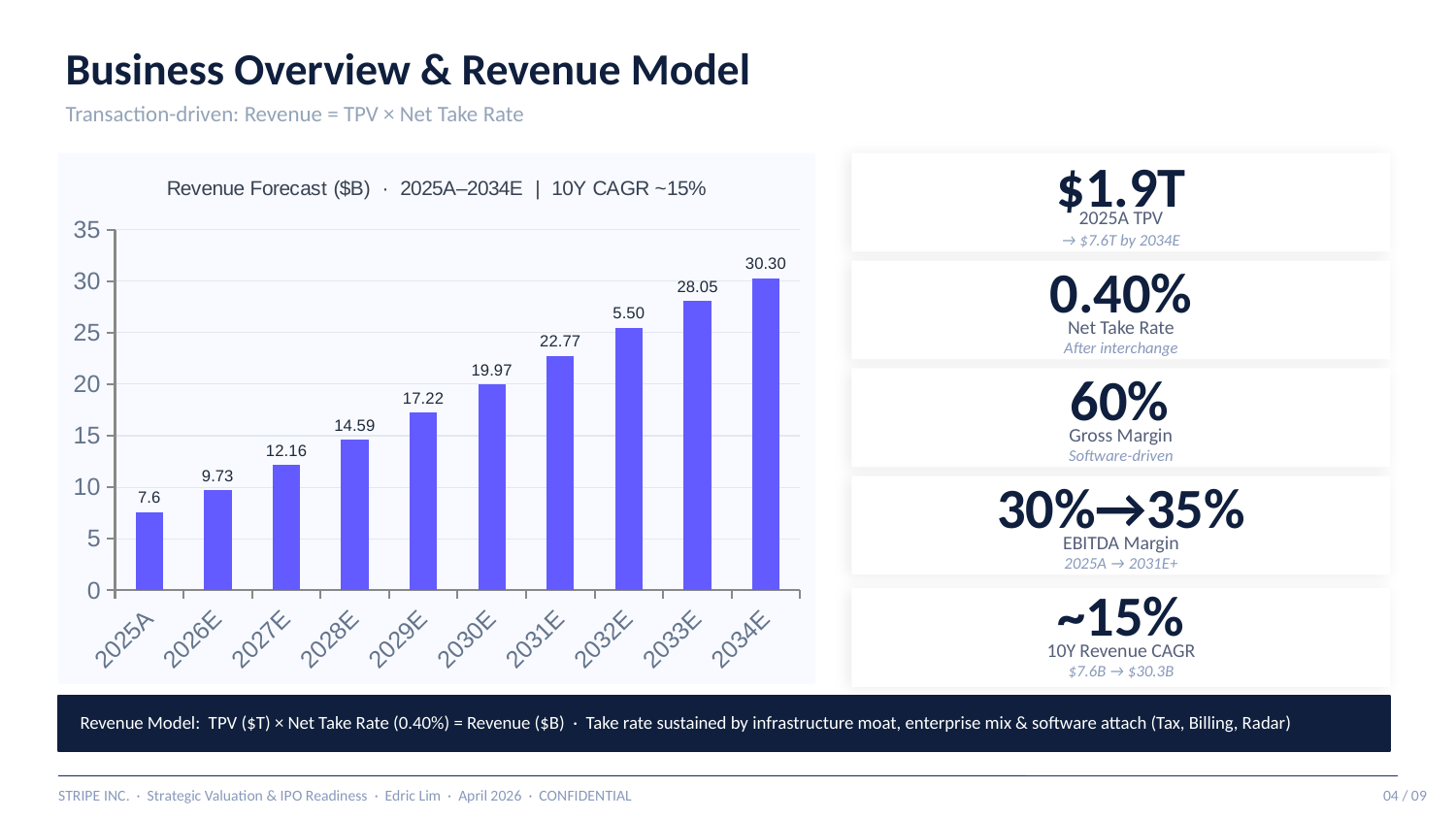
Do the revenue forecast values rise or fall from 2025A to 2034E? Rise Which year has the lowest revenue forecast? 2025A Which is larger, the revenue forecast for 2028E or 2027E? 2028E What is the revenue forecast value for 2034E? 30.30 What is the revenue forecast value for 2025A? 7.6 What is the revenue forecast value for 2030E? 19.97 Is the revenue forecast value for 2029E greater or less than 15? greater How many years are shown on the x axis of the revenue forecast chart? 10 Which year has the highest revenue forecast? 2034E What kind of chart is used to show the revenue forecast? Bar chart What is the difference between the revenue forecast for 2034E and 2025A? 22.70 What is the difference between the revenue forecast for 2033E and 2031E? 5.28